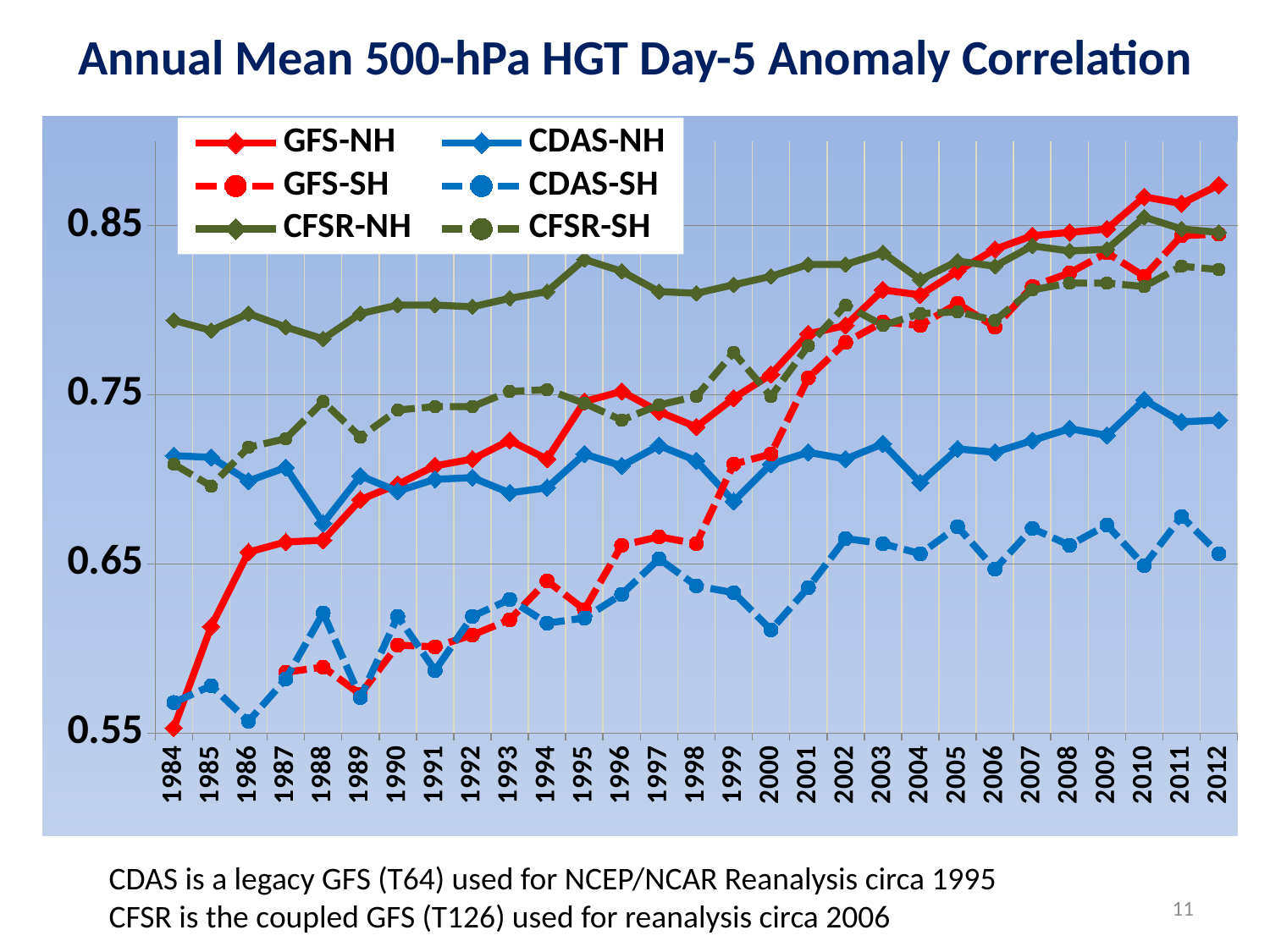
How many years are plotted along the x axis? 29 Is the value for CDAS-SH in 2000 greater or less than 0.65? less In 1984, which is larger: CFSR-NH or GFS-NH? CFSR-NH Which series has the highest value in 2012? GFS-NH Which series has the lowest value in 2012? CDAS-SH Which series has the lowest value in 1984? GFS-NH Is the value for GFS-NH in 2012 greater or less than 0.85? greater Which series are drawn with dashed lines? GFS-SH, CDAS-SH and CFSR-SH What is the title of the chart? Annual Mean 500-hPa HGT Day-5 Anomaly Correlation Does the GFS-NH series rise or fall from 1984 to 2012? Rise How many series does the legend list? 6 What kind of chart is shown on the slide? Line chart